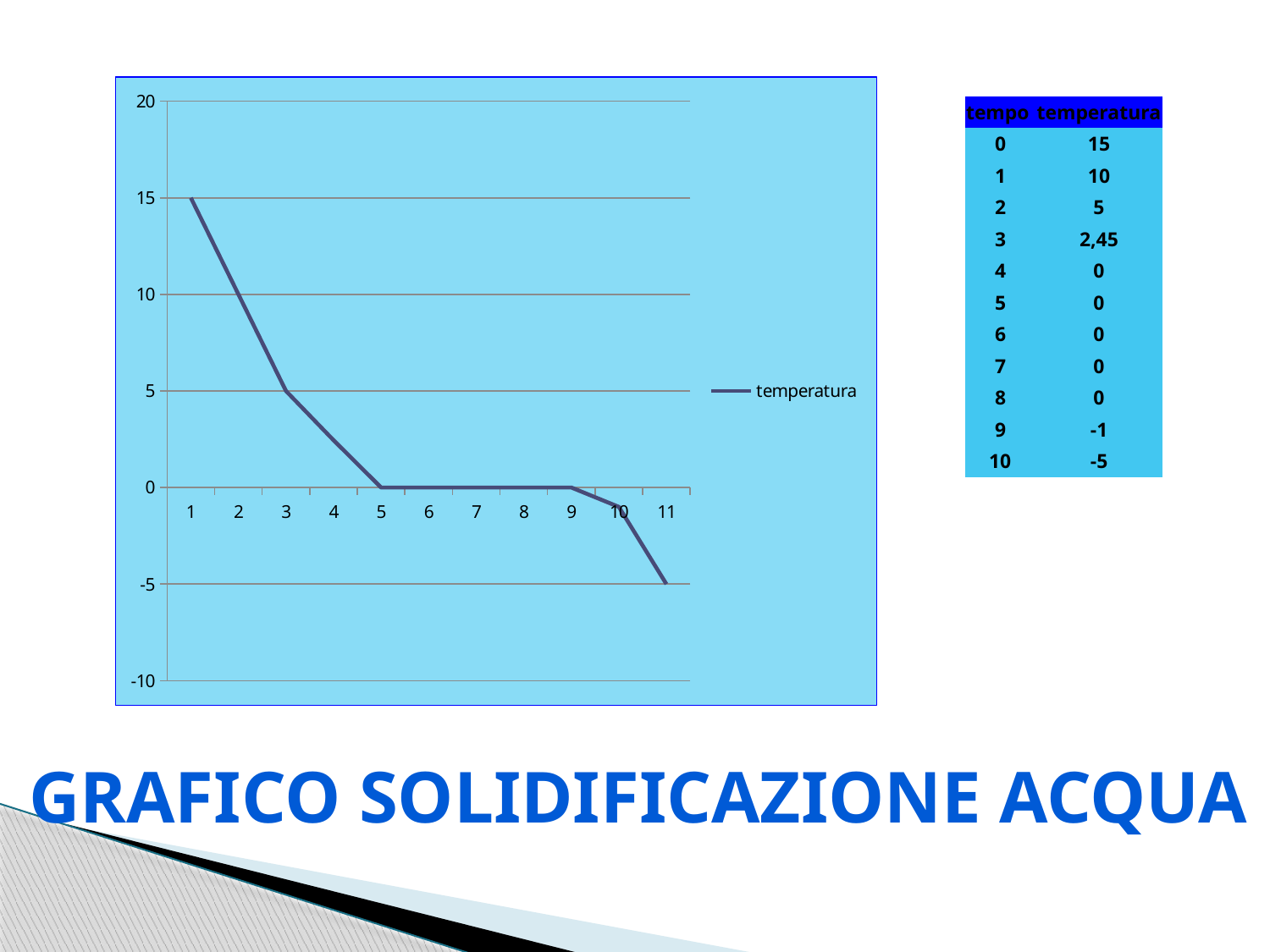
What is the value of temperatura at x = 11 on the chart? -5 How many series does the chart legend list? 1 What is the value of temperatura at x = 3 on the chart? 5 At which x value does the temperatura line reach its highest value? 1 At which x value does the temperatura line reach its lowest value? 11 What kind of chart is shown on the slide? line chart What is the name of the series shown in the chart legend? temperatura Is the temperatura value at x = 4 greater or less than 5? less What is the difference between the temperatura value at x = 1 and at x = 11? 20 Do the temperatura values rise or fall overall from left to right along the x axis? fall What is the value of temperatura at x = 1 on the chart? 15 How many points are plotted along the x axis of the chart? 11